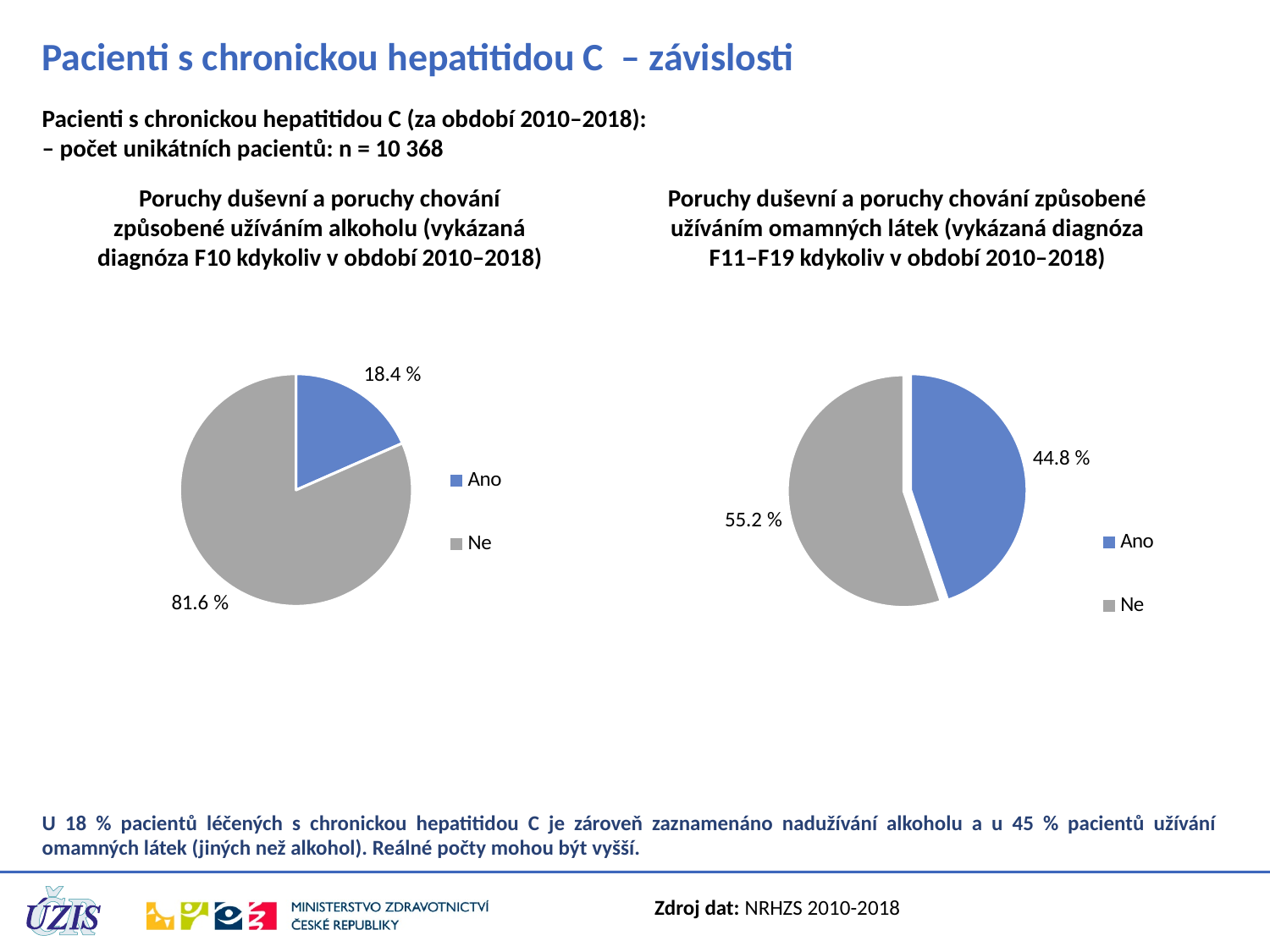
In the right pie chart (omamné látky, F11–F19), what share is labelled "Ano"? 44.8 % In the right pie chart (omamné látky, F11–F19), what share is labelled "Ne"? 55.2 % What type of chart is used on the left side of the slide? Pie chart In the left pie chart (alcohol, F10), what share is labelled "Ne"? 81.6 % In the left pie chart (alcohol, F10), which slice is the largest? Ne In the left pie chart (alcohol, F10), what share is labelled "Ano"? 18.4 % In the left pie chart (alcohol, F10), what is the difference between the "Ne" and "Ano" shares? 63.2 % In the right pie chart (omamné látky, F11–F19), what is the difference between the "Ne" and "Ano" shares? 10.4 % In the right pie chart (omamné látky, F11–F19), which slice is the smallest? Ano In the left pie chart (alcohol, F10), what colour is the "Ano" slice? Blue Which chart has the larger "Ano" share, the left pie chart (alcohol) or the right pie chart (omamné látky)? The right pie chart (omamné látky) How many slices does the right pie chart (omamné látky, F11–F19) have? 2